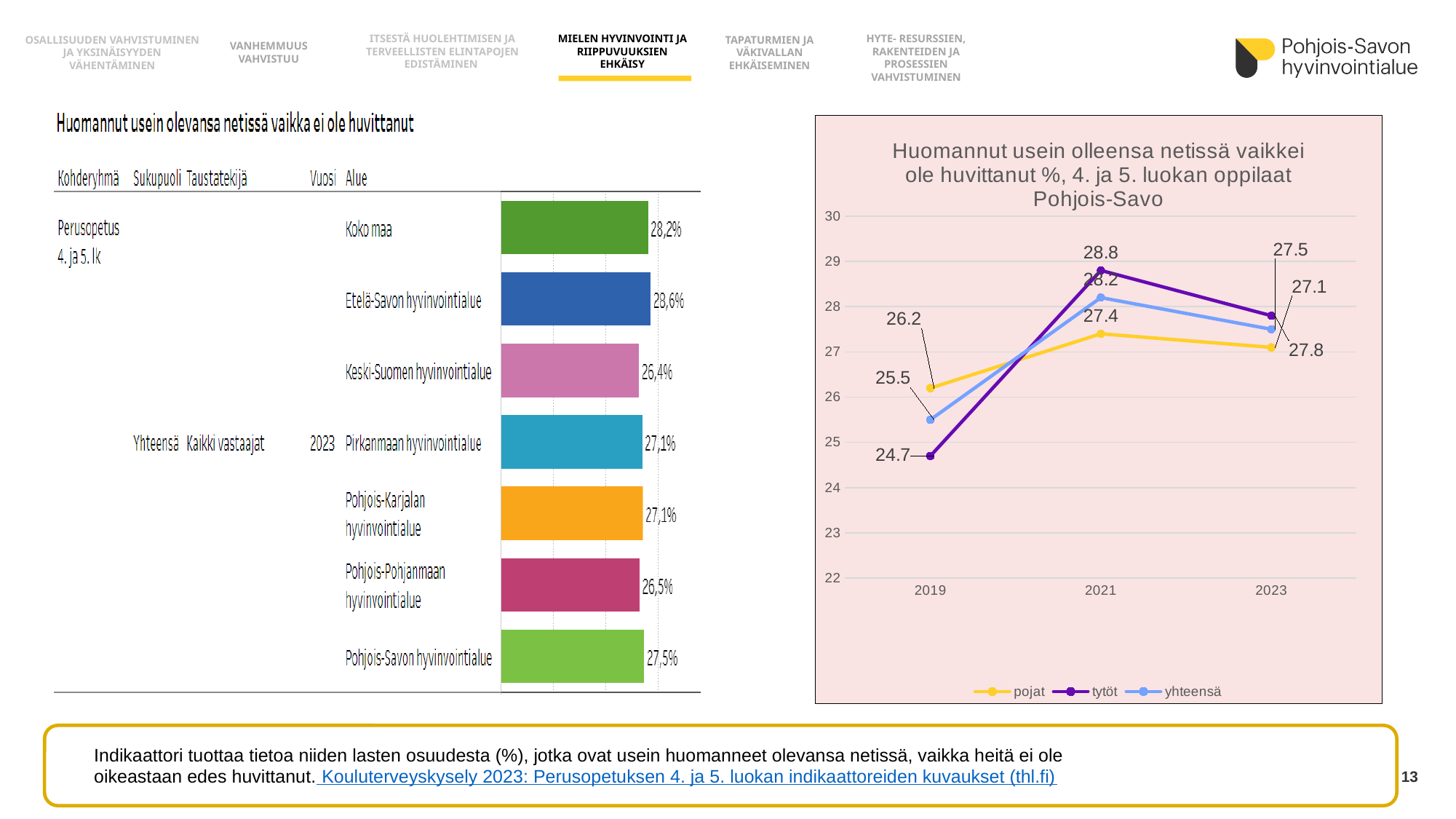
In the right line chart, what is the value for pojat in 2019? 26.2 In the left bar chart, what is the difference between Etelä-Savon hyvinvointialue and Keski-Suomen hyvinvointialue? 2,2 percentage points In the left bar chart, what is the value for Koko maa? 28,2% In the right line chart, which series has the lowest value in 2019? tytöt In the right line chart, what is the value for tytöt in 2021? 28.8 What type of chart is the chart on the left side of the slide? Bar chart How many series does the legend of the right line chart list? 3 In the left bar chart, which region has the lowest value? Keski-Suomen hyvinvointialue In the left bar chart, what is the value for Pohjois-Savon hyvinvointialue? 27,5% In the left bar chart, which region has the highest value? Etelä-Savon hyvinvointialue In the right line chart, does the value for tytöt rise or fall from 2019 to 2021? Rise In the left bar chart, how many regions (bars) are shown? 7